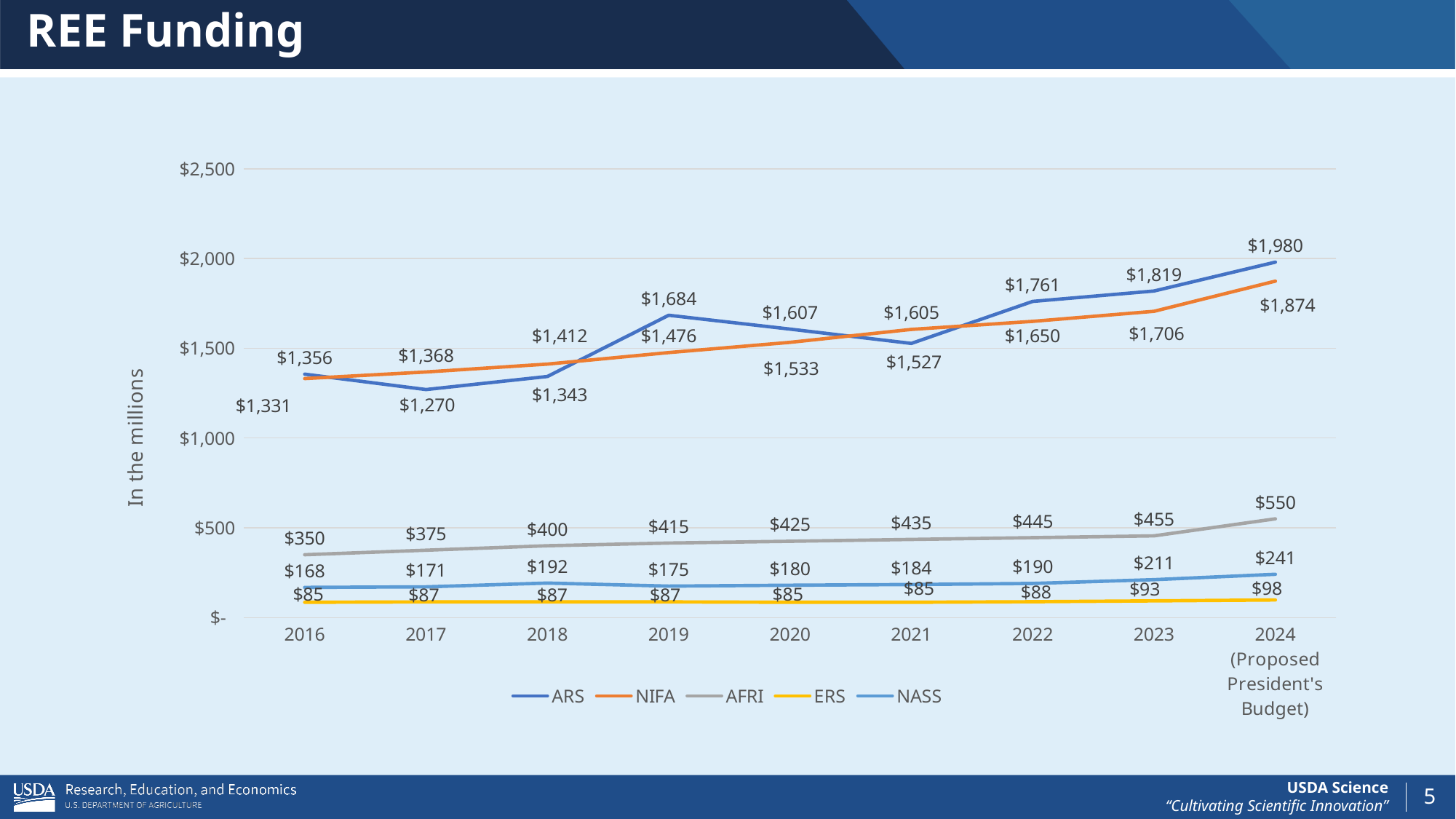
Which series has the larger value in 2021, ARS or NIFA? NIFA In which year is the NASS value highest? 2024 (Proposed President's Budget) What is the ERS value for 2023? $93 What is the AFRI value for 2024 (Proposed President's Budget)? $550 In which year is the ARS value lowest? 2017 What is the ARS funding value for 2019? $1,684 What is the NIFA funding value for 2020? $1,533 How many series does the legend list? 5 How many years are shown on the x axis? 9 Is the ARS value for 2022 greater or less than $1,500? greater What kind of chart is shown on the slide? Line chart What is the difference between the ARS and NIFA values in 2024 (Proposed President's Budget)? $106